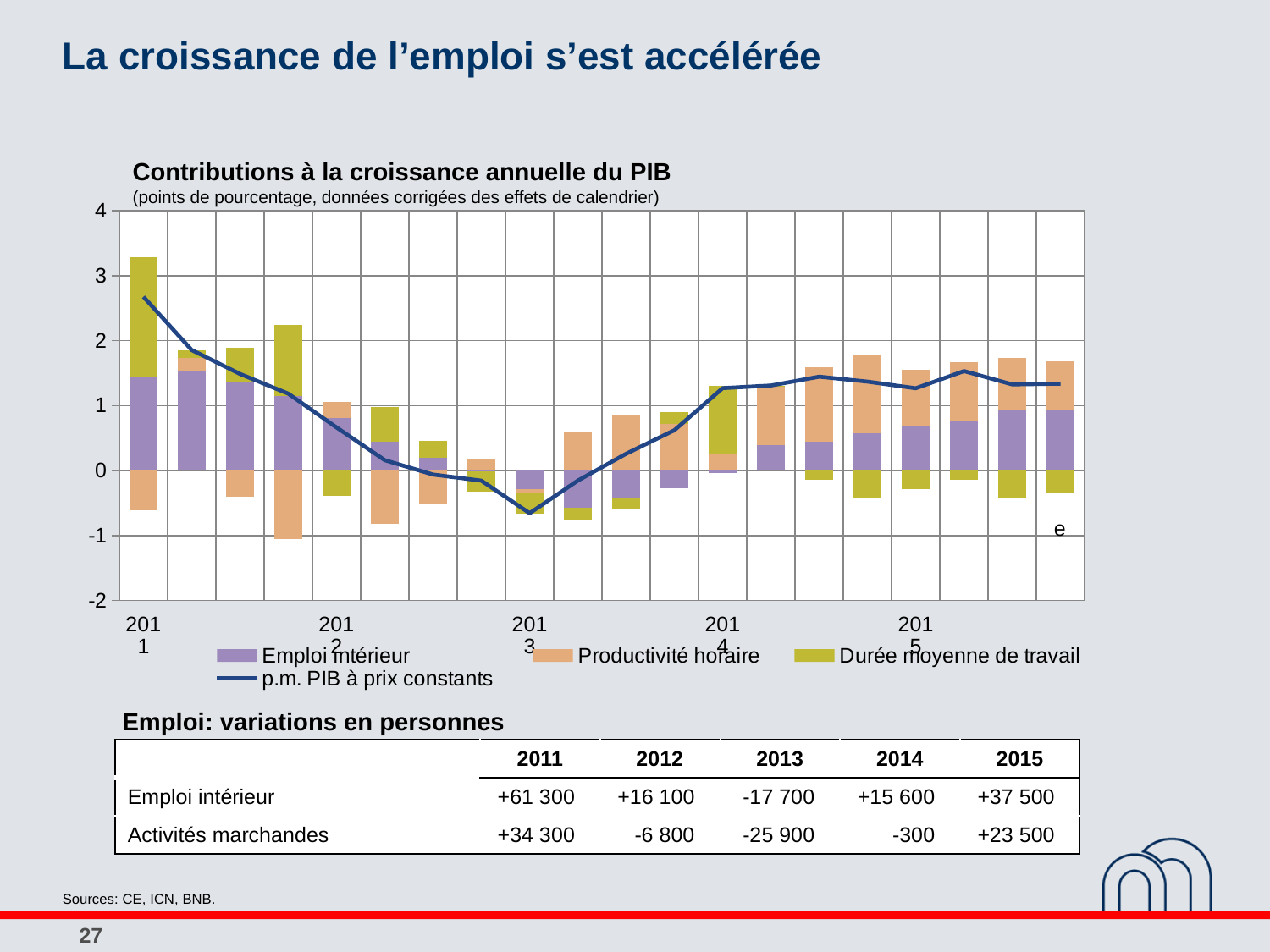
In which year does the tallest stacked bar of the chart appear? 2011 Is the value of the 'p.m. PIB à prix constants' line at the last point of 2015 greater or less than 1? greater How many series does the legend of the chart list? 4 Is the value of the 'p.m. PIB à prix constants' line at the first point of 2011 greater or less than 2? greater Does the 'p.m. PIB à prix constants' line rise or fall from the start of 2011 to the start of 2013? fall What kind of chart is shown under the title 'Contributions à la croissance annuelle du PIB'? Stacked bar chart with a line How many stacked bars are plotted in the chart? 20 Is the value of the 'p.m. PIB à prix constants' line at the start of 2013 greater or less than 0? less Which series in the chart is drawn as a line rather than bars? p.m. PIB à prix constants What colour are the 'Emploi intérieur' bars in the chart? Purple Does the 'p.m. PIB à prix constants' line rise or fall from the start of 2013 to the start of 2014? rise